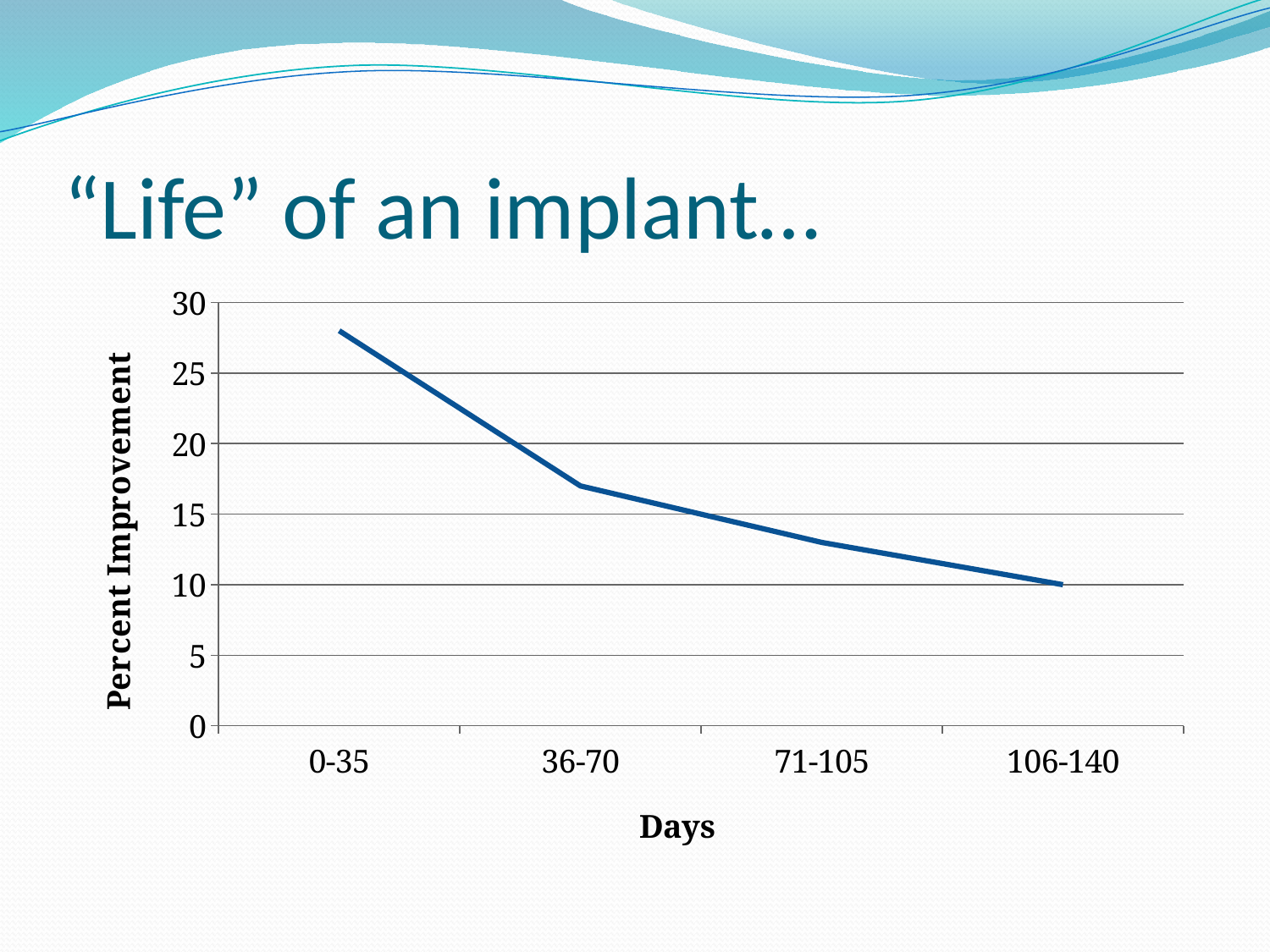
Which day range has the highest percent improvement? 0-35 Is the percent improvement for the 36-70 day range greater or less than 20? less What is the label of the x axis? Days Which has a larger percent improvement, the 36-70 day range or the 71-105 day range? 36-70 What is the percent improvement for the 106-140 day range? 10 How many day ranges are plotted along the x axis? 4 What kind of chart is shown on the slide? line chart Which day range has the lowest percent improvement? 106-140 Is the percent improvement for the 0-35 day range greater or less than 25? greater Is the percent improvement for the 71-105 day range greater or less than 15? less Does the percent improvement rise or fall as the days increase? fall What is the label of the y axis? Percent Improvement